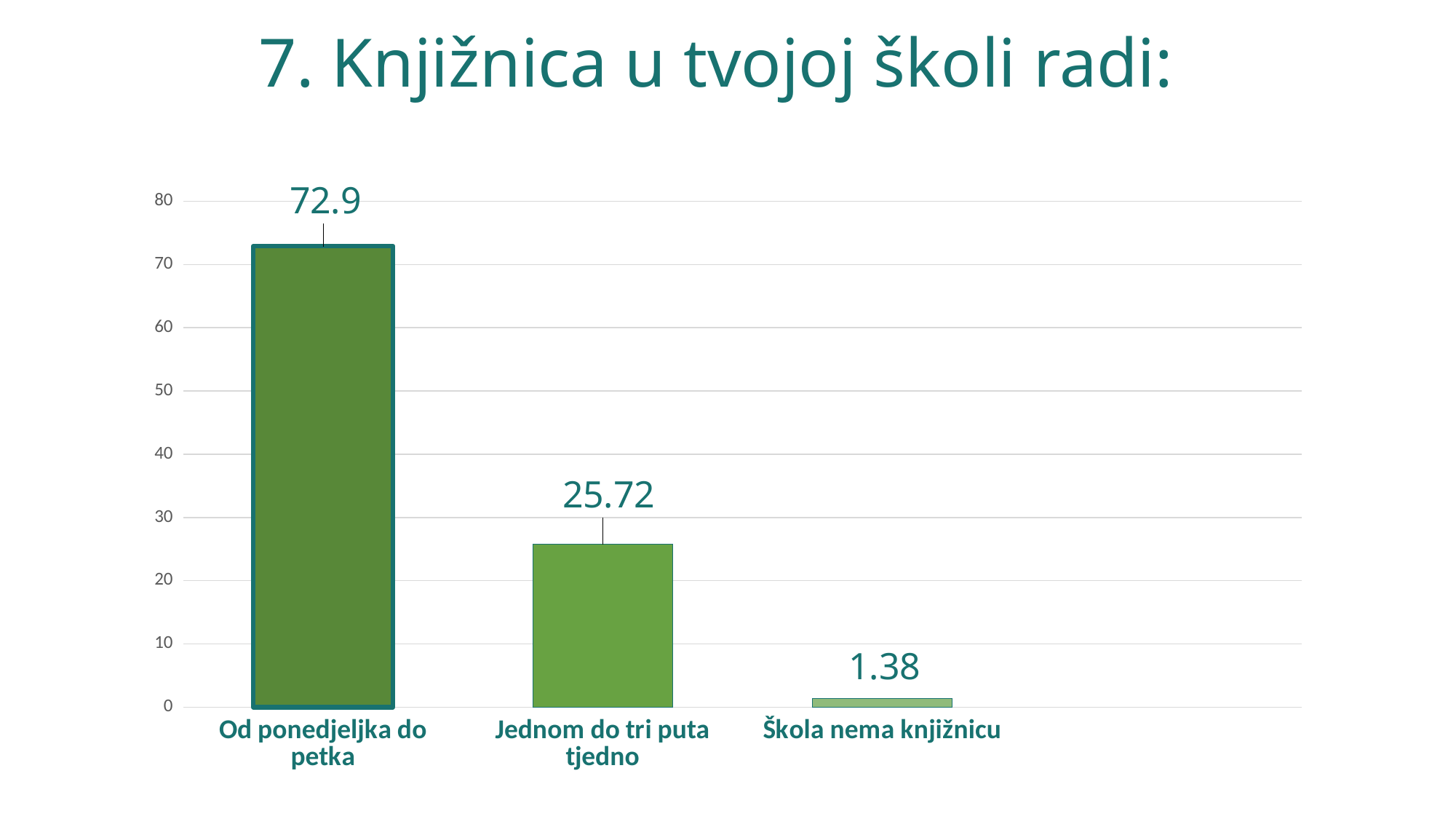
What is the title of the slide? 7. Knjižnica u tvojoj školi radi: What is the value for 'Škola nema knjižnicu'? 1.38 Which category has the highest value? Od ponedjeljka do petka What is the value for 'Od ponedjeljka do petka'? 72.9 Which category has the lowest value? Škola nema knjižnicu Is the value for 'Od ponedjeljka do petka' greater or less than 70? greater Which is larger, the value for 'Jednom do tri puta tjedno' or the value for 'Škola nema knjižnicu'? Jednom do tri puta tjedno What is the difference between the values for 'Od ponedjeljka do petka' and 'Jednom do tri puta tjedno'? 47.18 What is the value for 'Jednom do tri puta tjedno'? 25.72 What kind of chart is shown on the slide? bar chart What is the difference between the values for 'Jednom do tri puta tjedno' and 'Škola nema knjižnicu'? 24.34 How many categories are shown in the chart? 3